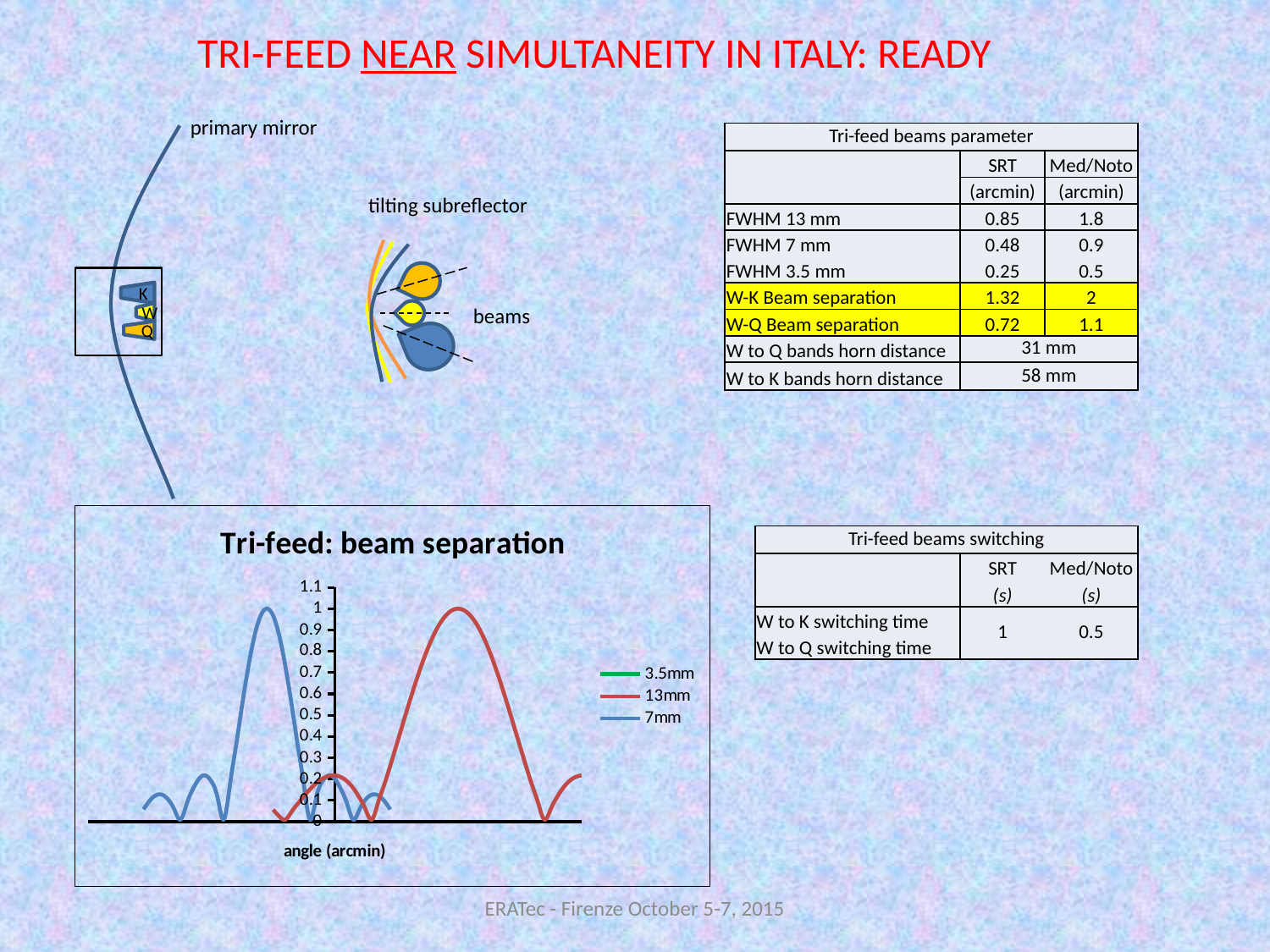
How many series does the legend of the "Tri-feed: beam separation" chart list? 3 In the "Tri-feed: beam separation" chart, is the highest sidelobe of the 7mm series greater or less than 0.5? less In the "Tri-feed: beam separation" chart, is the peak value of the 13mm series greater or less than 0.8? greater What is the x-axis label of the "Tri-feed: beam separation" chart? angle (arcmin) What kind of chart is "Tri-feed: beam separation"? line chart In the "Tri-feed: beam separation" chart, is the peak value of the 7mm series greater or less than 0.9? greater In the "Tri-feed: beam separation" chart, what is the lowest tick value shown on the y axis? 0 In the "Tri-feed: beam separation" chart, what is the highest tick value shown on the y axis? 1.1 In the "Tri-feed: beam separation" chart, which series is plotted in red? 13mm In the "Tri-feed: beam separation" chart, which series has the wider main peak, 7mm or 13mm? 13mm What is the title of the chart on the slide? Tri-feed: beam separation